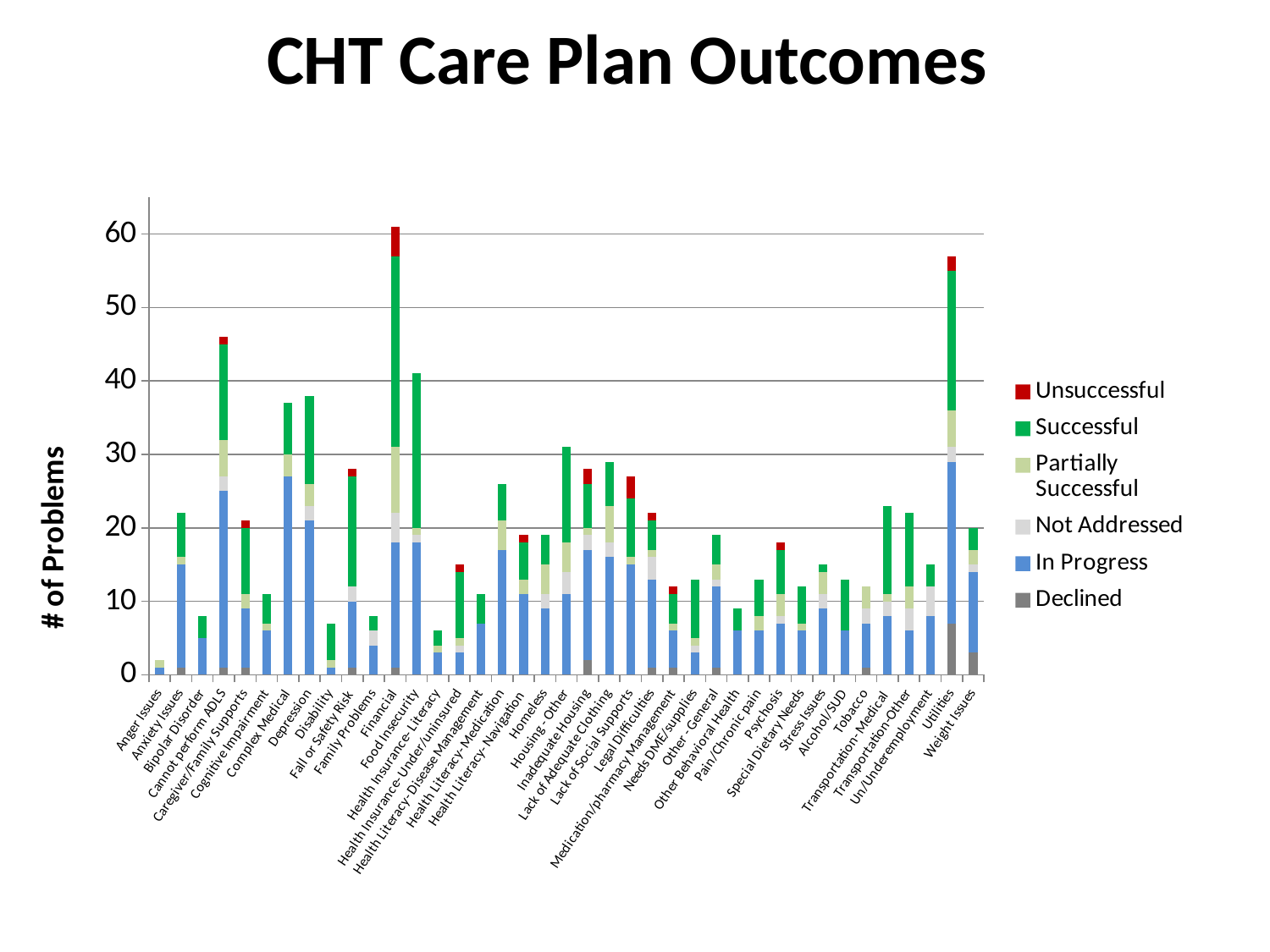
How many series does the legend list? 6 Is the total value for Depression greater or less than 30? greater What is the label on the y axis? # of Problems Is the total value for Cannot perform ADLS greater or less than 40? greater Is the total value for Disability greater or less than 10? less Which category has the shortest stacked bar overall? Anger Issues Which category has the tallest stacked bar overall? Financial Which has the larger total, Anxiety Issues or Bipolar Disorder? Anxiety Issues How many categories are shown along the x axis? 39 What is the title of the chart? CHT Care Plan Outcomes What kind of chart is shown on the slide? Stacked bar chart